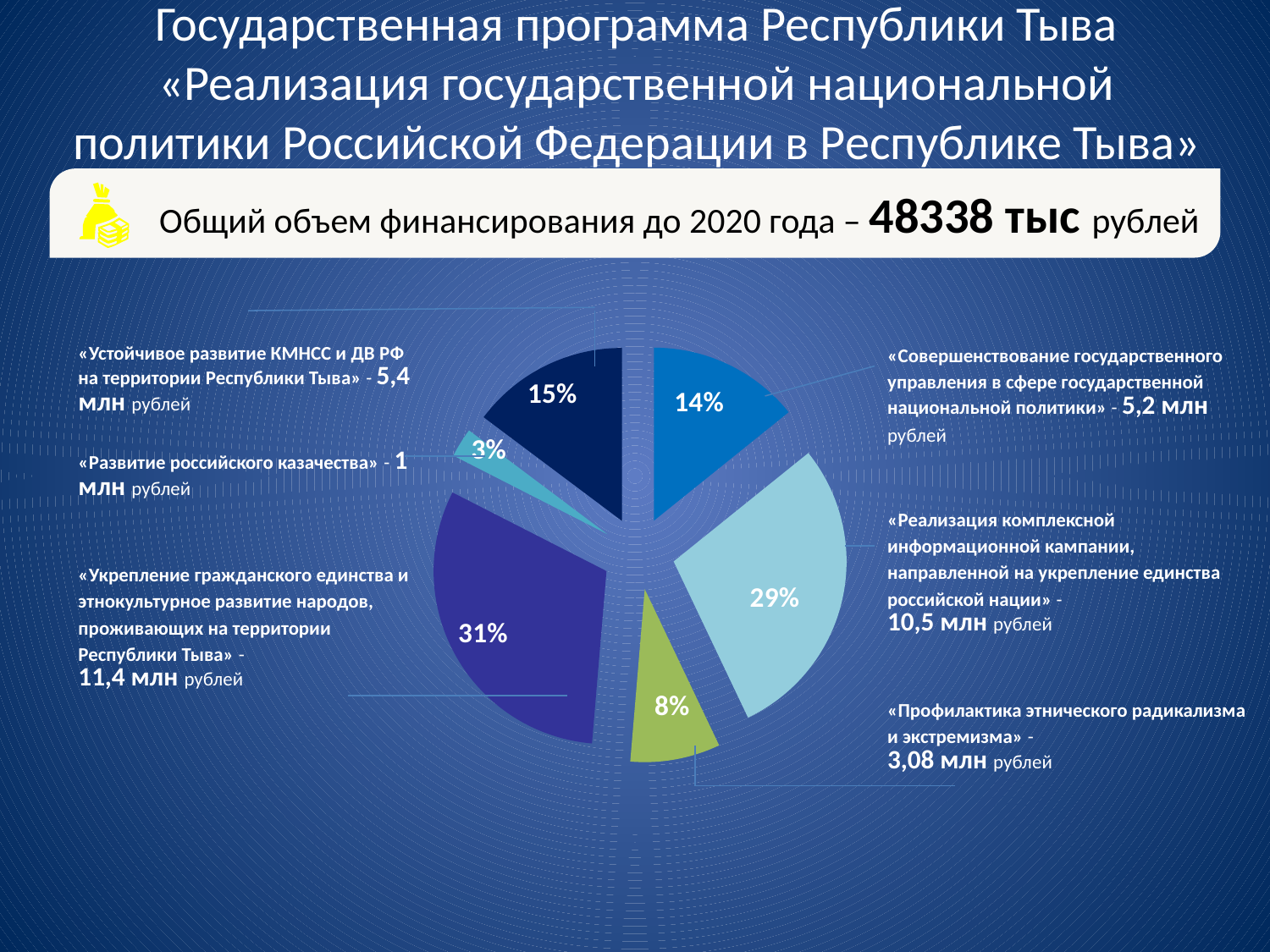
What total funding volume up to 2020 is stated on the slide? 48338 тыс рублей What share of the pie is labelled 31%, and which programme does it correspond to? «Укрепление гражданского единства и этнокультурное развитие народов, проживающих на территории Республики Тыва» - 11,4 млн рублей What percentage share is shown for «Реализация комплексной информационной кампании, направленной на укрепление единства российской нации»? 29% Which slice of the pie chart is the largest? 31% («Укрепление гражданского единства и этнокультурное развитие народов...») What is the funding amount for «Устойчивое развитие КМНСС и ДВ РФ на территории Республики Тыва»? 5,4 млн рублей Which slice of the pie chart is the smallest? 3% («Развитие российского казачества») What percentage share is shown for «Профилактика этнического радикализма и экстремизма»? 8% What is the funding amount for «Совершенствование государственного управления в сфере государственной национальной политики»? 5,2 млн рублей What is the difference in percentage points between the 31% slice and the 29% slice? 2 percentage points How many slices does the pie chart have? 6 What kind of chart is shown on the slide? Pie chart Which is larger: the 14% slice or the 15% slice? The 15% slice